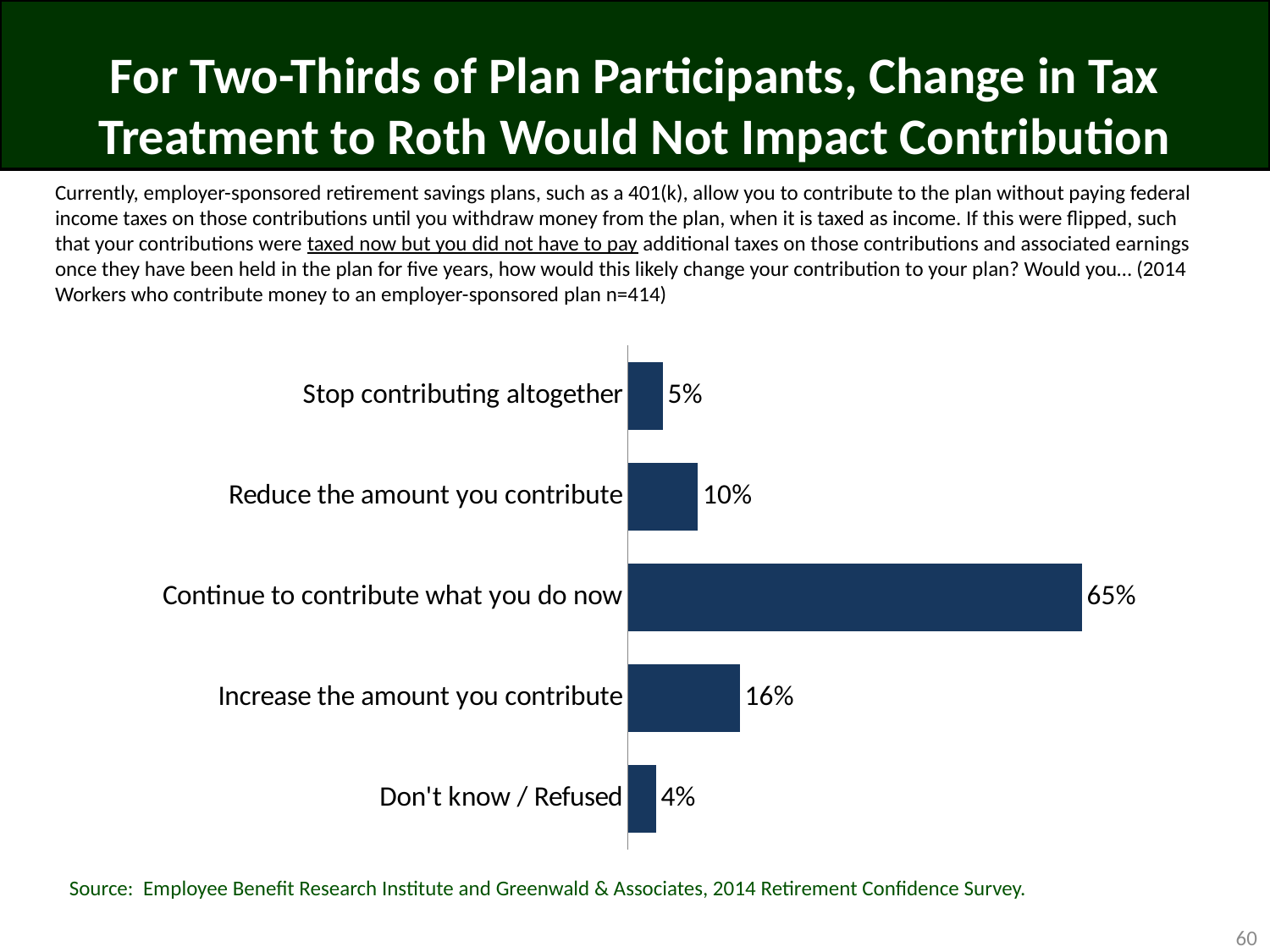
What percentage of plan participants answered Don't know / Refused? 4% How many response categories are shown in the chart? 5 What percentage of plan participants would continue to contribute what they do now? 65% Which response has the lowest percentage? Don't know / Refused Which is larger: the percentage for 'Reduce the amount you contribute' or 'Stop contributing altogether'? Reduce the amount you contribute What is the difference in percentage points between 'Continue to contribute what you do now' and 'Increase the amount you contribute'? 49 percentage points What kind of chart is shown on the slide? Bar chart What percentage of plan participants would increase the amount they contribute? 16% Which response has the highest percentage? Continue to contribute what you do now What percentage of plan participants would stop contributing altogether? 5% What is the sample size (n) of workers who contribute to an employer-sponsored plan stated on the slide? 414 What is the difference in percentage points between 'Increase the amount you contribute' and 'Reduce the amount you contribute'? 6 percentage points